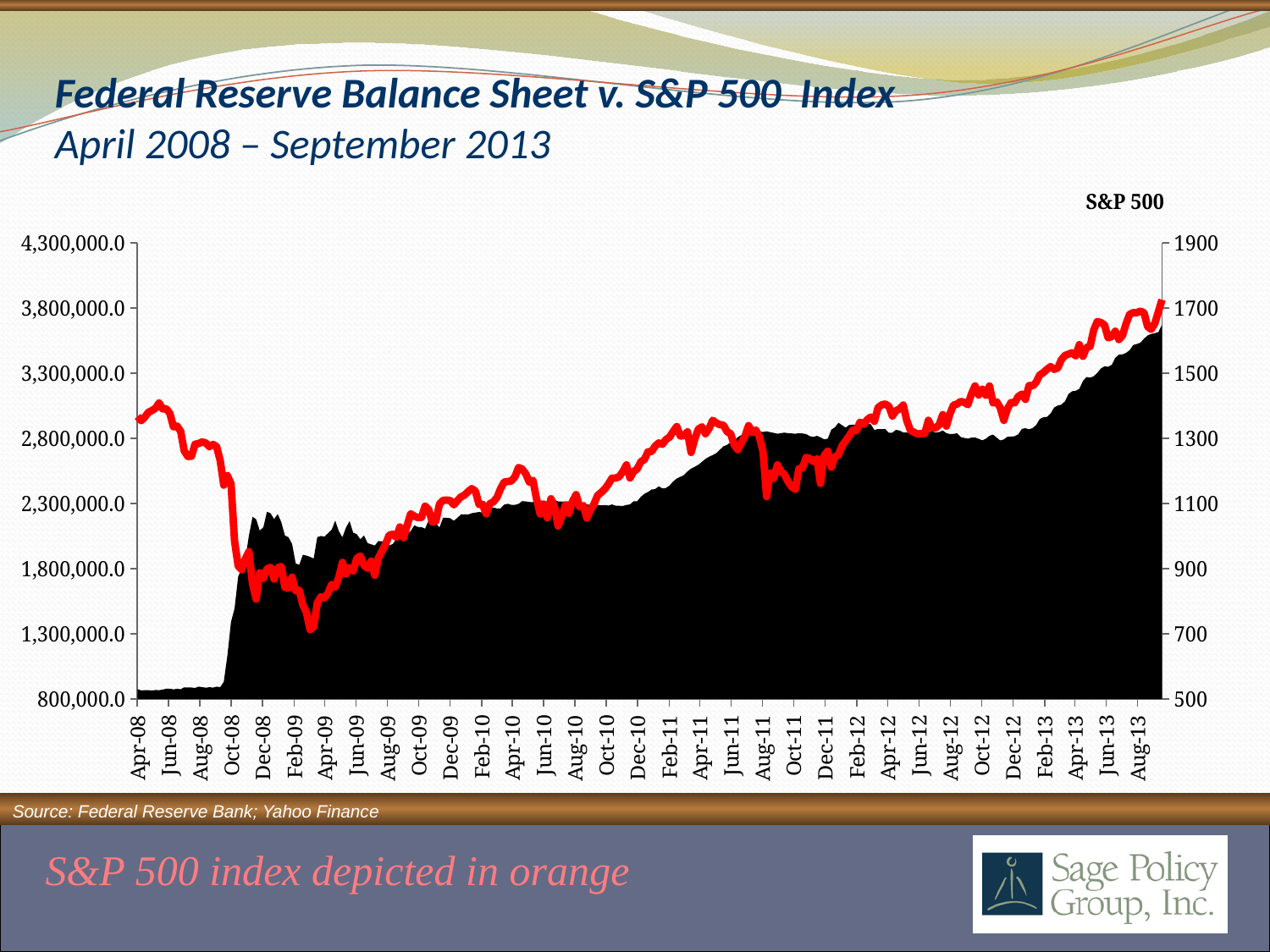
Is the S&P 500 value at Feb-09 greater or less than 900? less Does the black Federal Reserve balance sheet area rise or fall overall from Apr-08 to Aug-13? rise What kind of chart is shown on the slide? area chart with a line overlay Is the S&P 500 value at Aug-13 greater or less than 1500? greater What label appears above the right-hand axis of the chart? S&P 500 What is the title of the chart on the slide? Federal Reserve Balance Sheet v. S&P 500 Index How many data series are plotted on the chart? 2 Does the S&P 500 line rise or fall overall from Apr-08 to Aug-13? rise Is the Federal Reserve balance sheet value at Aug-13 greater or less than 3,300,000.0? greater Is the S&P 500 higher at Aug-13 or at Feb-09? Aug-13 Is the Federal Reserve balance sheet larger at Aug-13 or at Apr-08? Aug-13